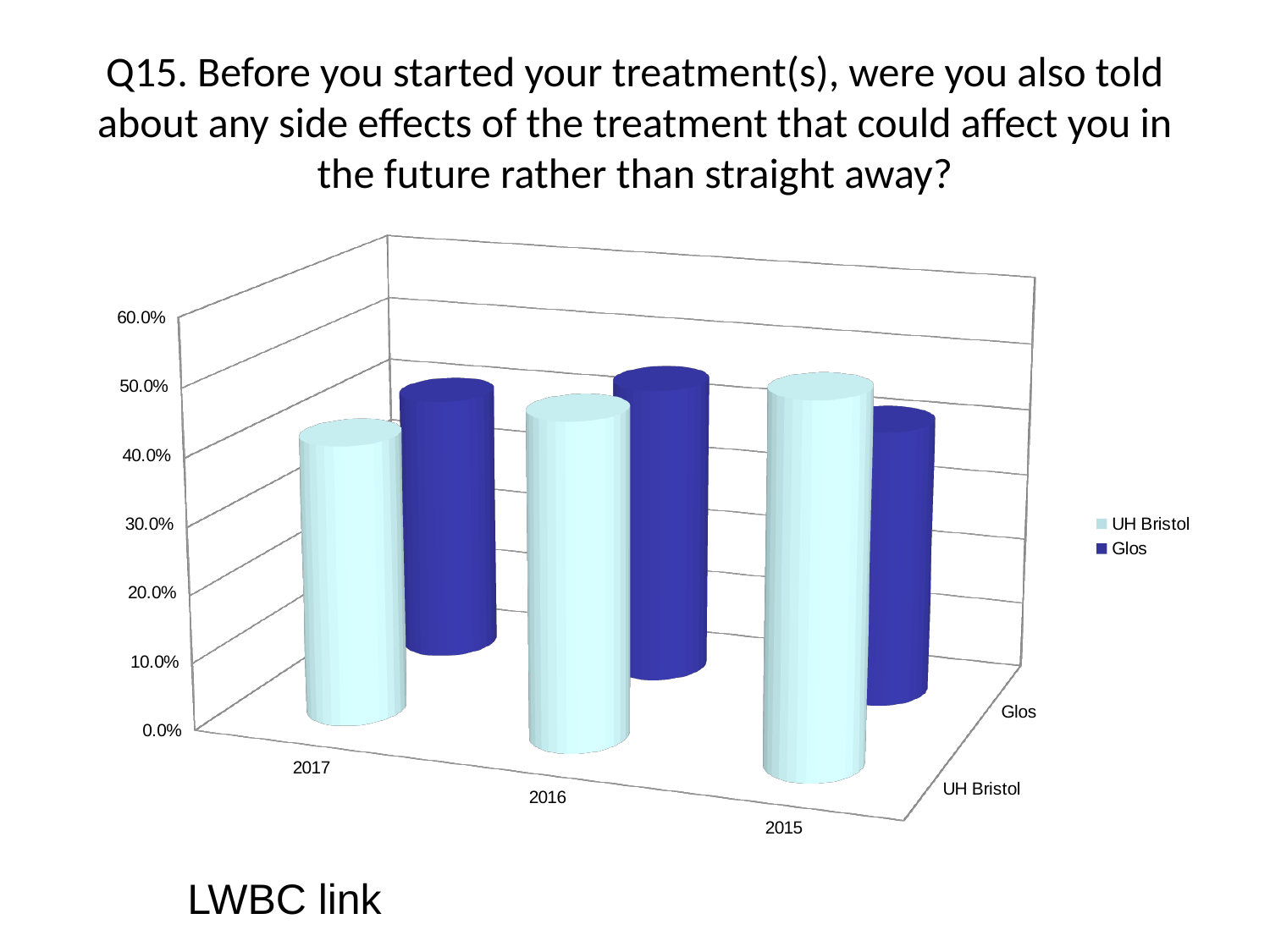
Is the value for Glos in 2017 greater or less than 20%? greater Do the UH Bristol values rise or fall from left to right along the x axis? rise Is the value for UH Bristol in 2017 greater or less than 30%? greater Which two series are listed in the legend? UH Bristol and Glos For the UH Bristol series, which year has the lowest value? 2017 How many series does the legend list? 2 Which years are shown on the x axis, from left to right? 2017, 2016, 2015 Is the value for UH Bristol in 2017 greater or less than 50%? less For the UH Bristol series, which year has the highest value? 2015 What kind of chart is shown on the slide? bar chart How many year categories are shown on the x axis? 3